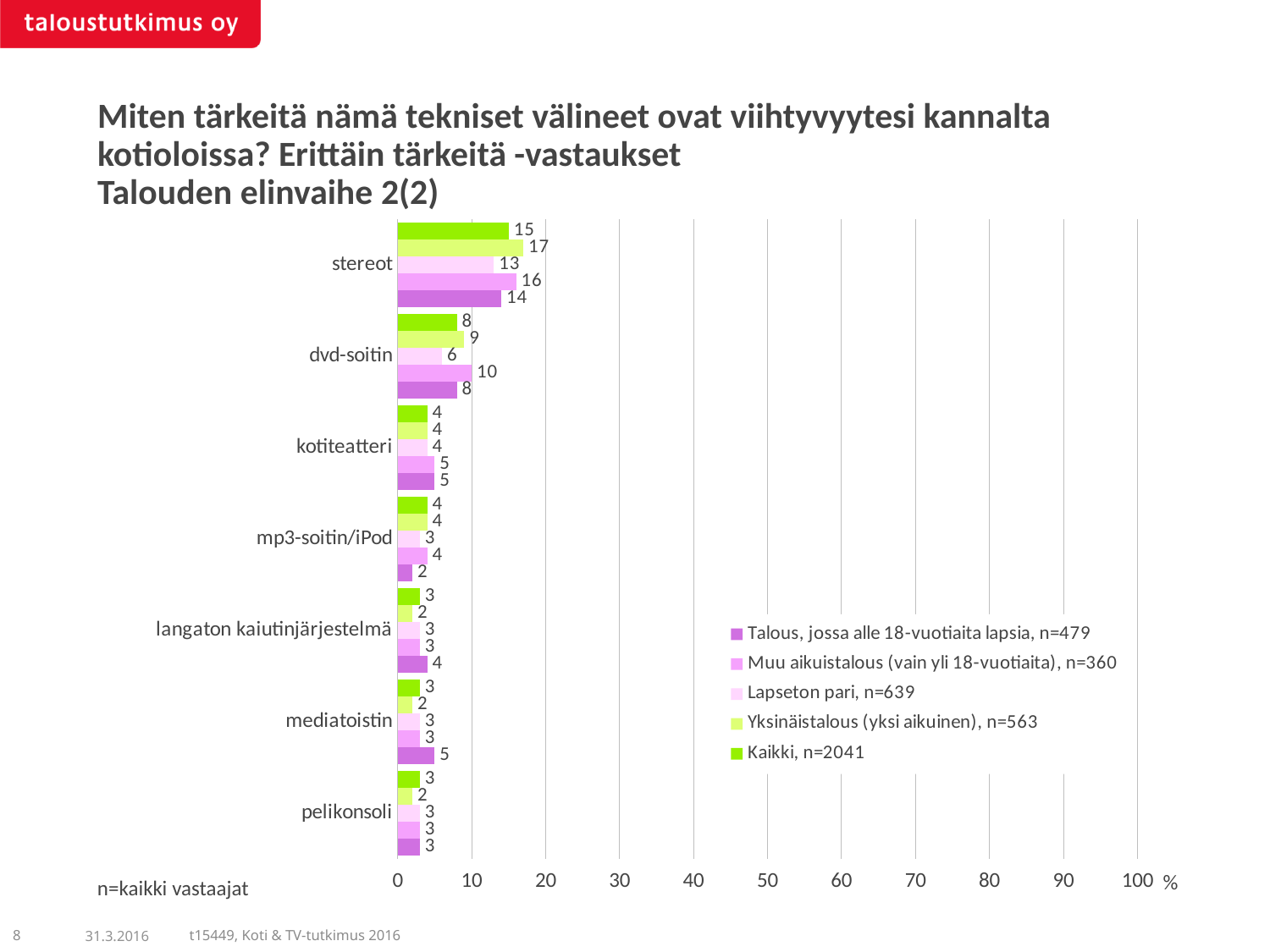
What is the value for stereot in the Lapseton pari, n=639 series? 13 Is the value for stereot in the Yksinäistalous (yksi aikuinen), n=563 series greater or less than 20? less How many categories (devices) are shown on the chart? 7 Which series has the highest value for stereot? Yksinäistalous (yksi aikuinen), n=563 What is the value for stereot in the Kaikki, n=2041 series? 15 For dvd-soitin, which is larger: the Muu aikuistalous (vain yli 18-vuotiaita), n=360 value or the Lapseton pari, n=639 value? Muu aikuistalous (vain yli 18-vuotiaita), n=360 What is the difference between the Yksinäistalous (yksi aikuinen), n=563 value and the Lapseton pari, n=639 value for stereot? 4 Which category has the highest value in the Kaikki, n=2041 series? stereot What kind of chart is shown on the slide? bar chart How many series does the legend list? 5 What is the value for dvd-soitin in the Muu aikuistalous (vain yli 18-vuotiaita), n=360 series? 10 What is the value for mediatoistin in the Talous, jossa alle 18-vuotiaita lapsia, n=479 series? 5